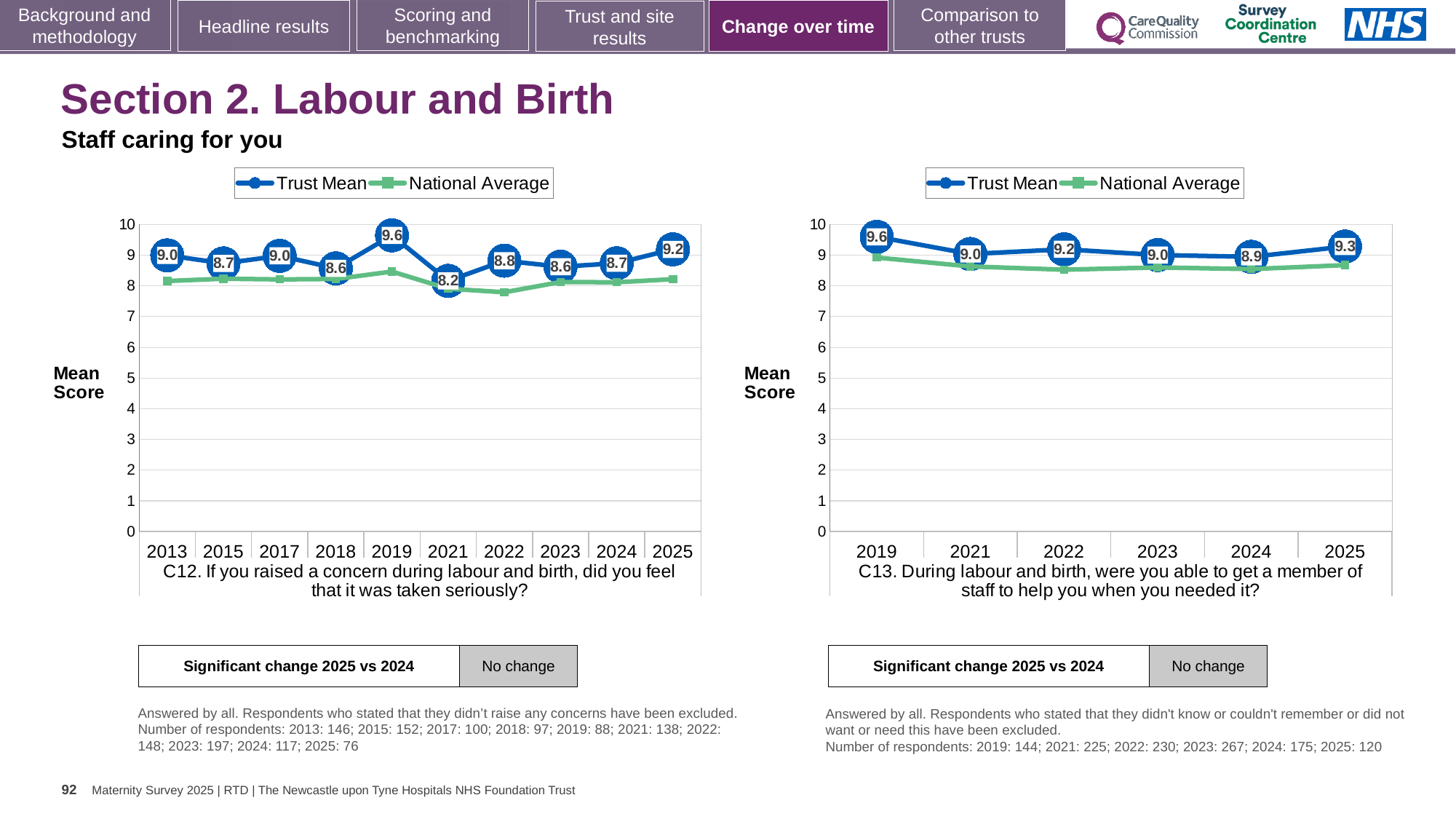
In the C12 chart (left), which year has the lowest Trust Mean? 2021 How many series does the legend of the C13 chart (right) list? 2 In the C12 chart (left), which year has the highest Trust Mean? 2019 In the C13 chart (right), is the Trust Mean for 2025 larger or smaller than the Trust Mean for 2024? larger In the C13 chart (right), which year has the lowest Trust Mean? 2024 In the C13 chart (right), what is the Trust Mean for 2019? 9.6 In the C13 chart (right), is the National Average for 2022 greater or less than 9? less In the C12 chart (left), what is the difference between the Trust Mean in 2019 and in 2021? 1.4 In the C12 chart (left), what is the Trust Mean for 2019? 9.6 How many years are plotted on the x axis of the C12 chart (left)? 10 In the C12 chart (left), what is the Trust Mean for 2025? 9.2 In the C13 chart (right), what is the Trust Mean for 2024? 8.9